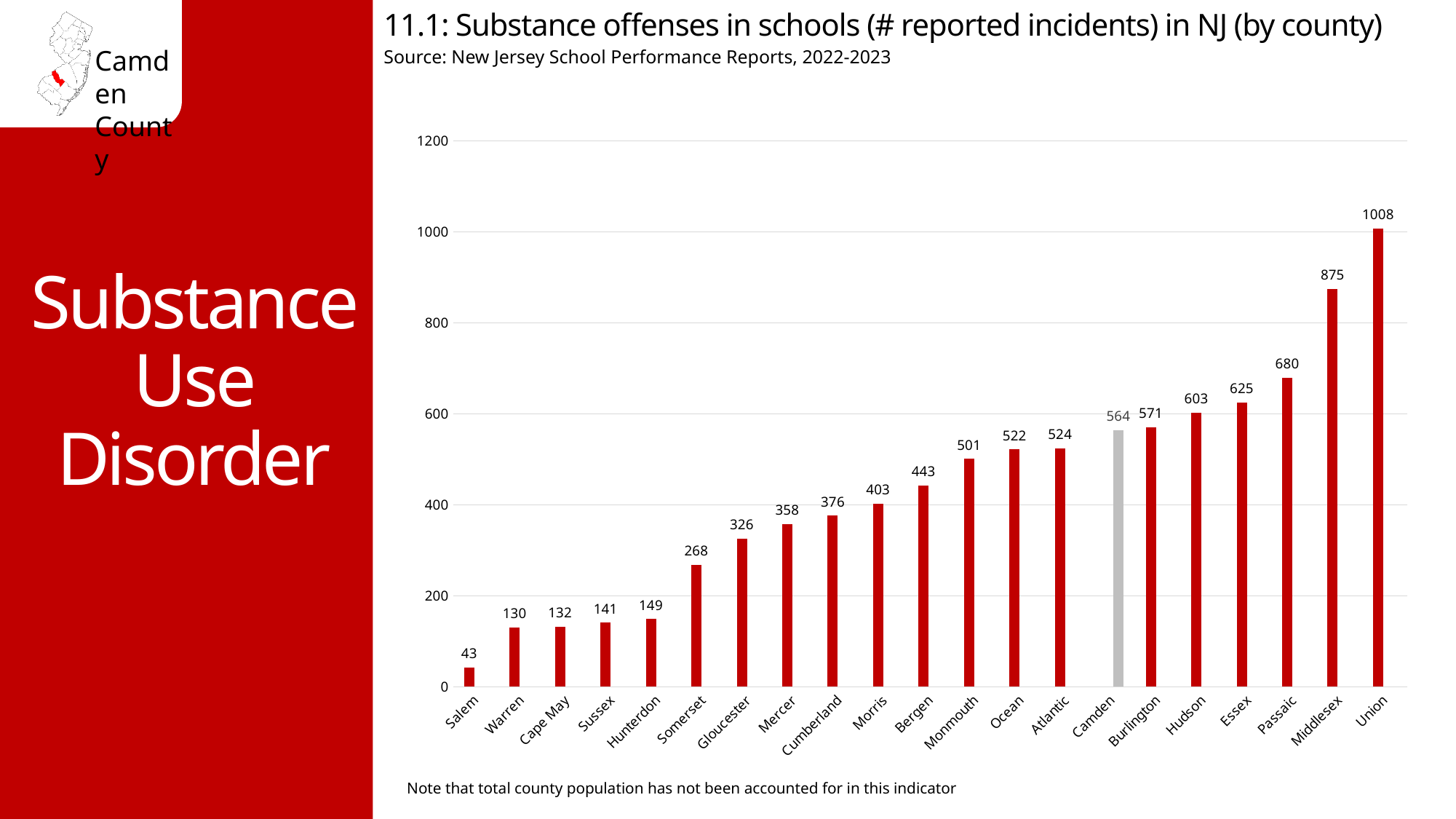
What kind of chart is shown on the slide? Bar chart What is the difference between the values for Camden and Burlington? 7 What is the difference between the values for Union and Middlesex? 133 How many counties are shown on the chart? 21 Which county has the highest number of reported incidents? Union Do the values rise or fall moving from left to right along the x axis? Rise What is the value shown for Gloucester county? 326 Is the value for Passaic greater or less than 600? greater Which county has the lowest number of reported incidents? Salem What is the number of reported substance offense incidents in schools for Camden county? 564 Which county has a larger value, Bergen or Monmouth? Monmouth Which county's bar is coloured grey instead of red? Camden